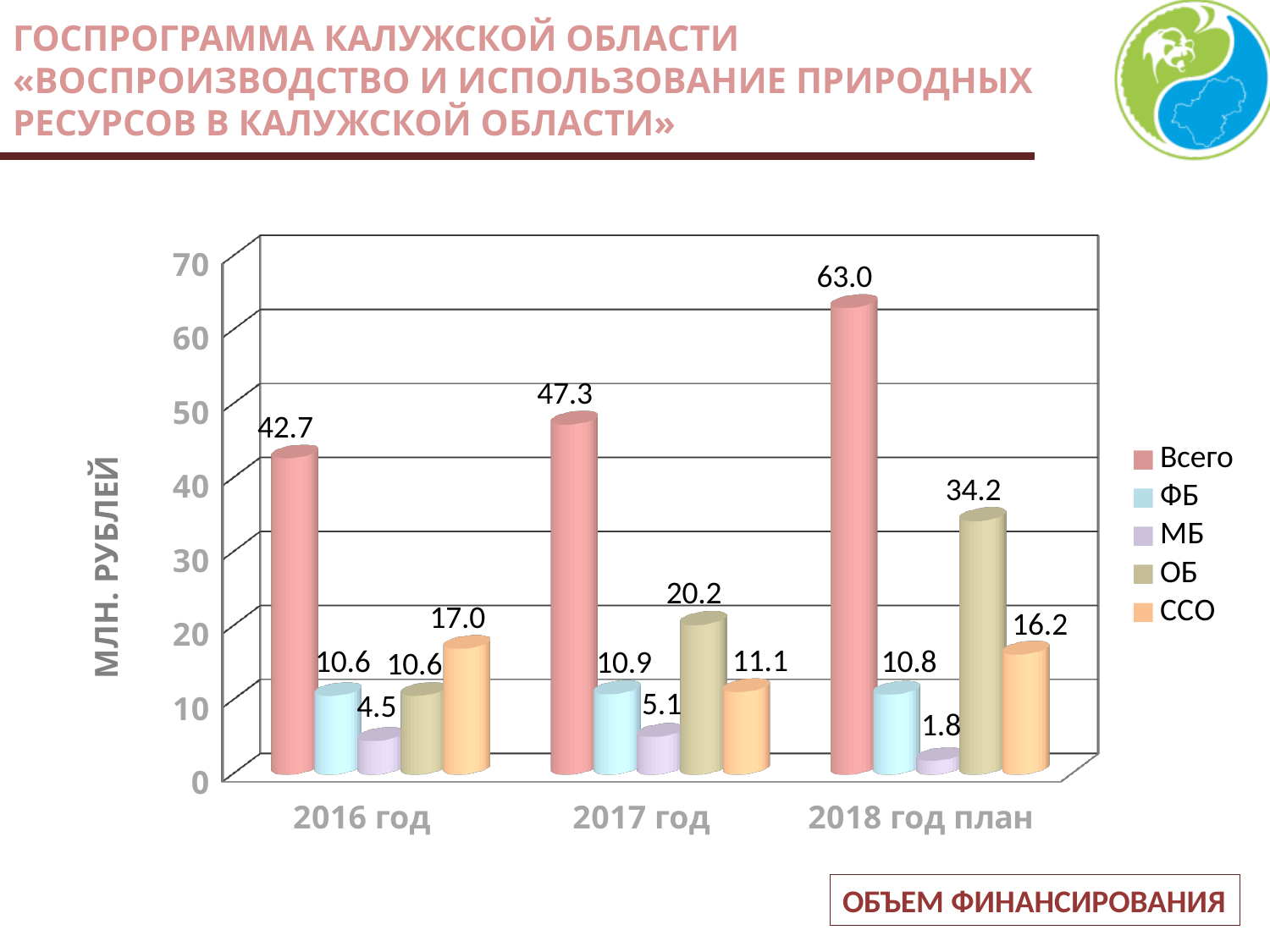
How many series does the legend list? 5 Does the Всего value rise or fall from 2016 год to 2018 год план? Rise What is the value for ОБ in 2017 год? 20.2 How many year categories are shown on the x axis? 3 What is the difference between the Всего values for 2018 год план and 2017 год? 15.7 In which year is the Всего value highest? 2018 год план What is the value for Всего in 2018 год план? 63.0 Which is larger in 2016 год: ФБ or ССО? ССО What is the value for МБ in 2016 год? 4.5 What is the value for ССО in 2018 год план? 16.2 In which year is the МБ value lowest? 2018 год план What kind of chart is shown on the slide? Bar chart